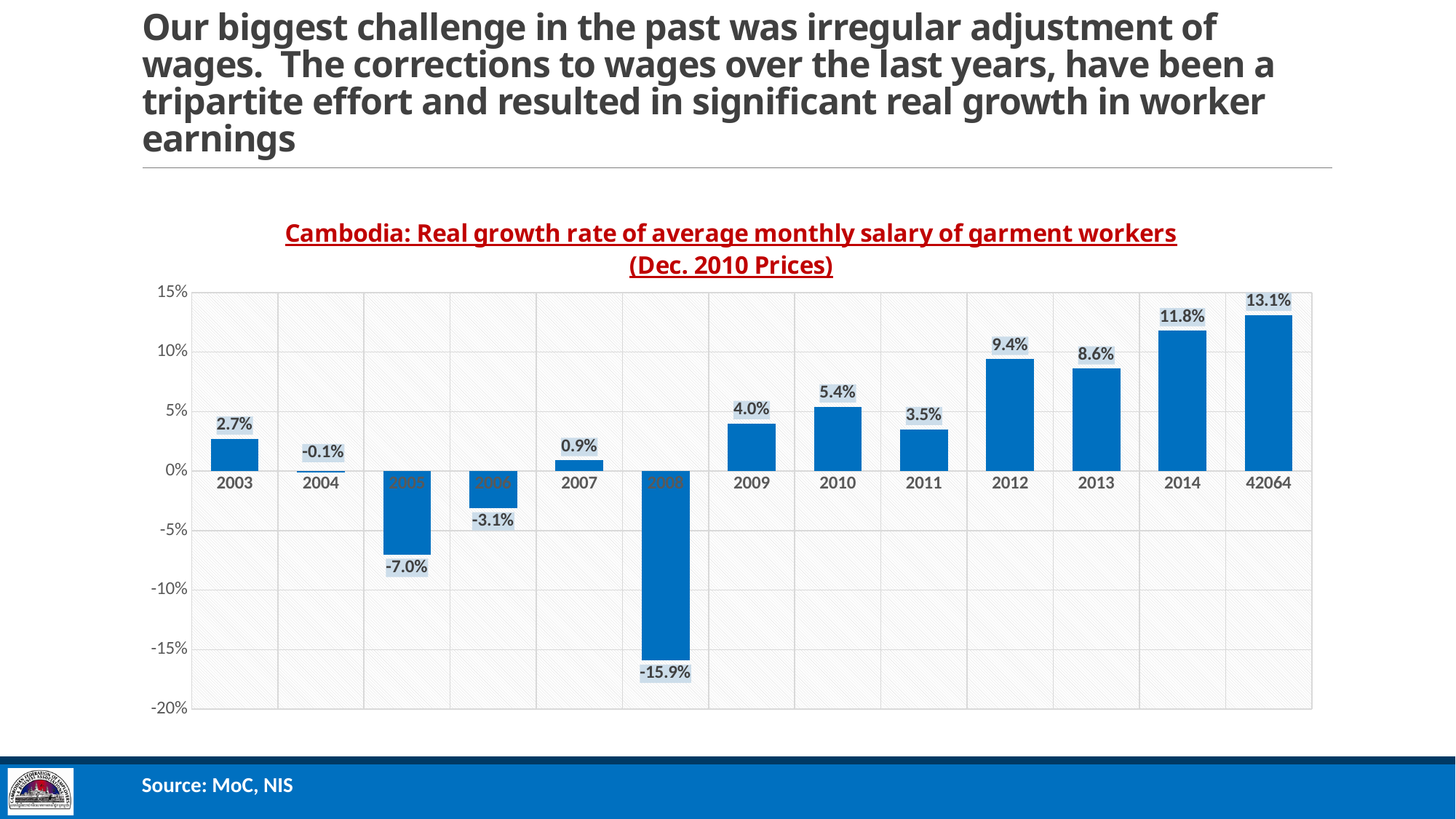
Do the values generally rise or fall from 2009 to the last bar? Rise What is the difference between the real growth rates for 2014 and 2013? 3.2% What kind of chart is shown on the slide? Bar chart What is the title of the chart? Cambodia: Real growth rate of average monthly salary of garment workers (Dec. 2010 Prices) How many years are shown on the x axis? 13 Is the value for 2005 greater or less than -5%? less What is the real growth rate shown for 2004? -0.1% Which year has the lowest real growth rate? 2008 Which year has the highest real growth rate? 42064 What is the real growth rate shown for 2012? 9.4% Which year has a higher real growth rate, 2010 or 2011? 2010 What is the real growth rate shown for 2008? -15.9%